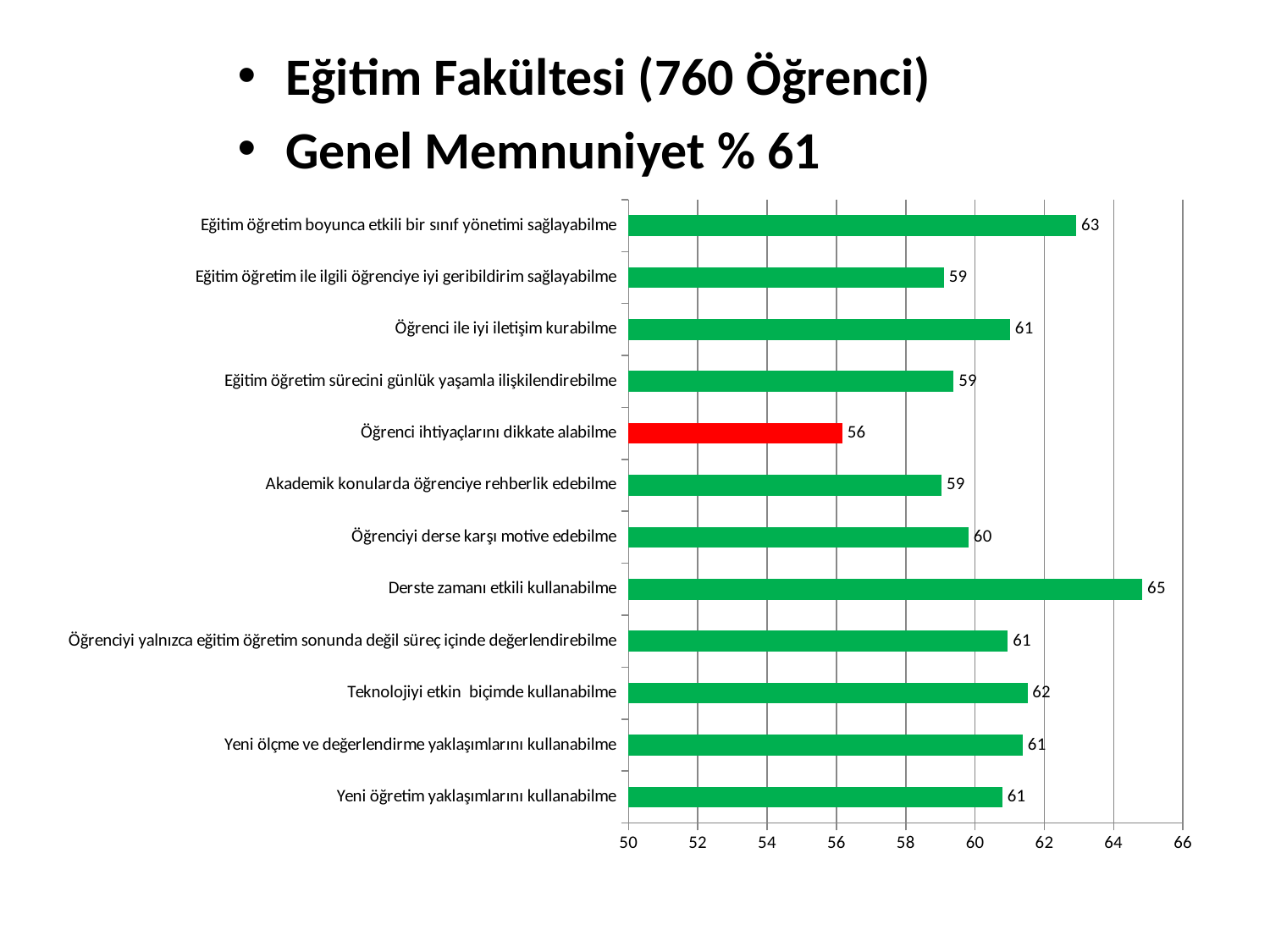
What is the value for "Derste zamanı etkili kullanabilme"? 65 Which bar is coloured red instead of green? Öğrenci ihtiyaçlarını dikkate alabilme What is the difference between the values for "Derste zamanı etkili kullanabilme" and "Öğrenci ihtiyaçlarını dikkate alabilme"? 9 Which category has the highest value? Derste zamanı etkili kullanabilme What kind of chart is shown on the slide? bar chart Is the value for "Öğrenci ihtiyaçlarını dikkate alabilme" greater or less than 58? less What is the value for "Öğrenci ihtiyaçlarını dikkate alabilme"? 56 Which is larger: the value for "Eğitim öğretim boyunca etkili bir sınıf yönetimi sağlayabilme" or the value for "Akademik konularda öğrenciye rehberlik edebilme"? Eğitim öğretim boyunca etkili bir sınıf yönetimi sağlayabilme What is the value for "Teknolojiyi etkin biçimde kullanabilme"? 62 What is the value for "Öğrenciyi derse karşı motive edebilme"? 60 Which category has the lowest value? Öğrenci ihtiyaçlarını dikkate alabilme How many categories are shown in the chart? 12